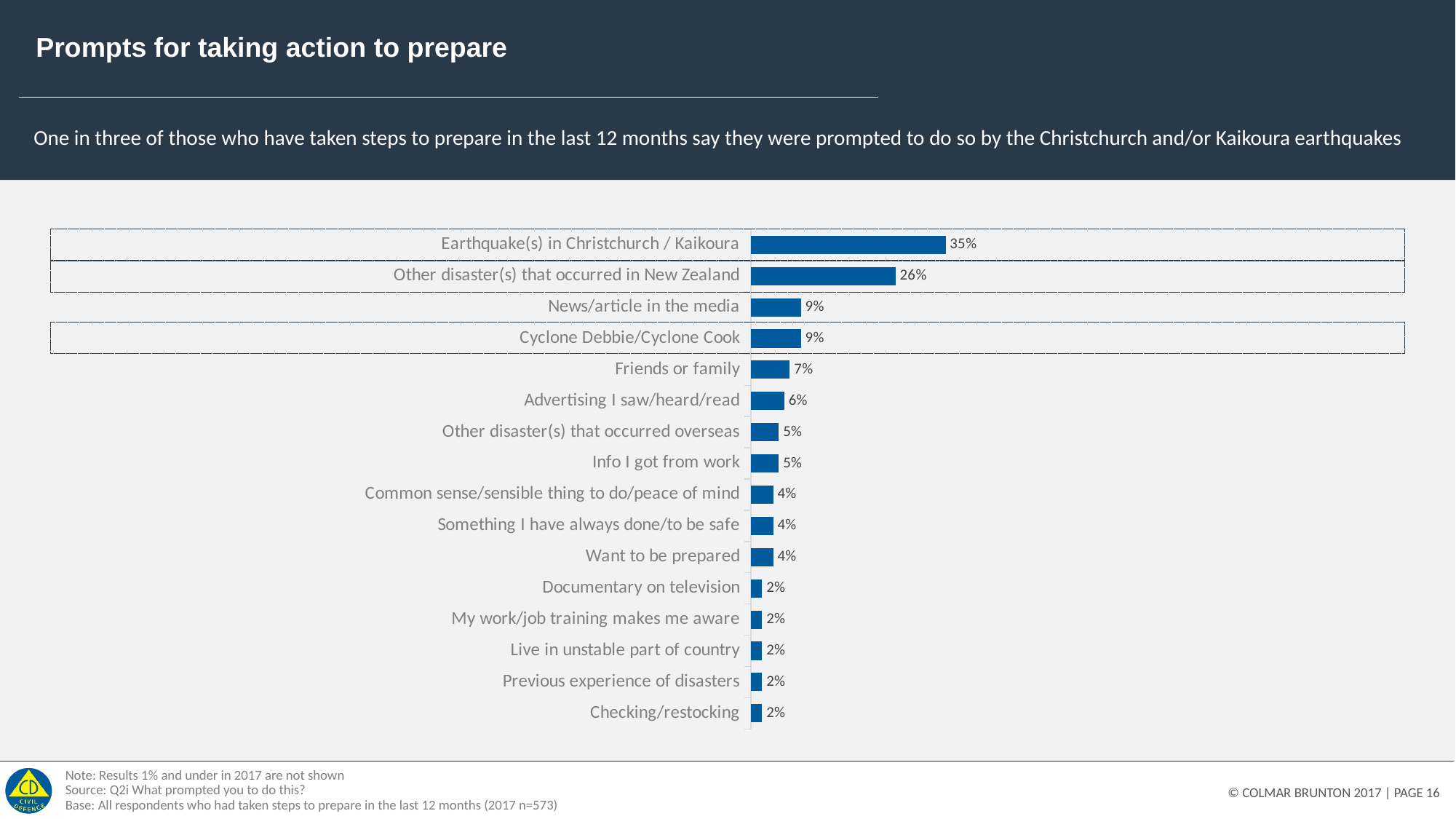
What is the difference between Cyclone Debbie/Cyclone Cook and Info I got from work? 4% What is the difference between Earthquake(s) in Christchurch / Kaikoura and Other disaster(s) that occurred in New Zealand? 9% Which category has the highest value? Earthquake(s) in Christchurch / Kaikoura What percentage of respondents said they were prompted by Earthquake(s) in Christchurch / Kaikoura? 35% How many categories are shown in the chart? 16 Which is larger: News/article in the media or Friends or family? News/article in the media What is the value for Documentary on television? 2% What kind of chart is shown on the slide? Bar chart What is the value for Friends or family? 7% What is the title of the slide? Prompts for taking action to prepare What is the value for Advertising I saw/heard/read? 6% What is the value for Other disaster(s) that occurred in New Zealand? 26%